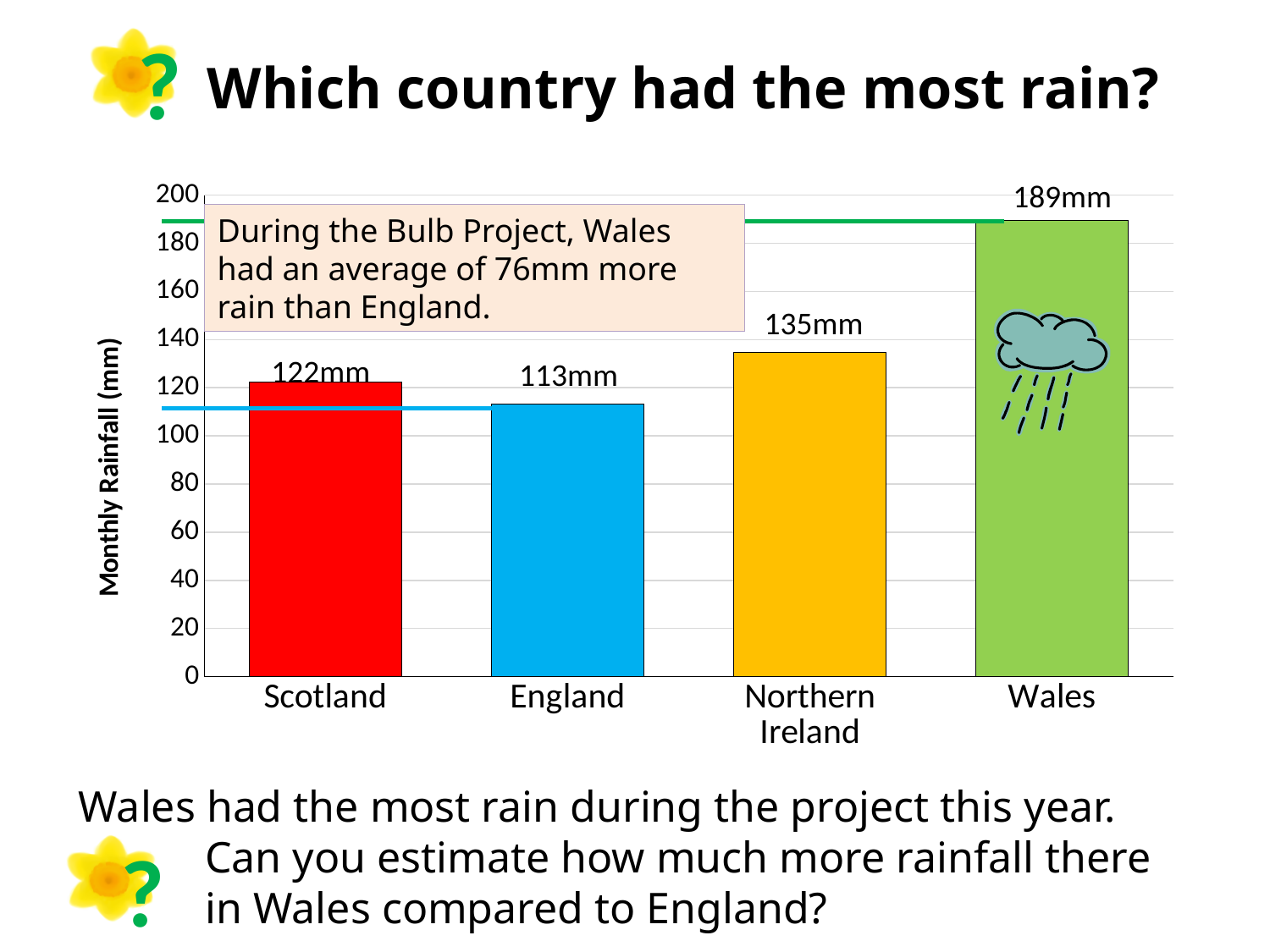
Which country has the lowest monthly rainfall? England Is the monthly rainfall for Wales greater or less than 180? greater What is the monthly rainfall for Scotland? 122mm What kind of chart is shown on the slide? bar chart What is the monthly rainfall for Northern Ireland? 135mm Which has more monthly rainfall, Scotland or Northern Ireland? Northern Ireland What is the difference in monthly rainfall between Northern Ireland and Scotland? 13mm What is the monthly rainfall for England? 113mm Which country has the highest monthly rainfall? Wales What is the monthly rainfall for Wales? 189mm How many countries are shown on the chart? 4 How much more monthly rainfall does Wales have than England? 76mm